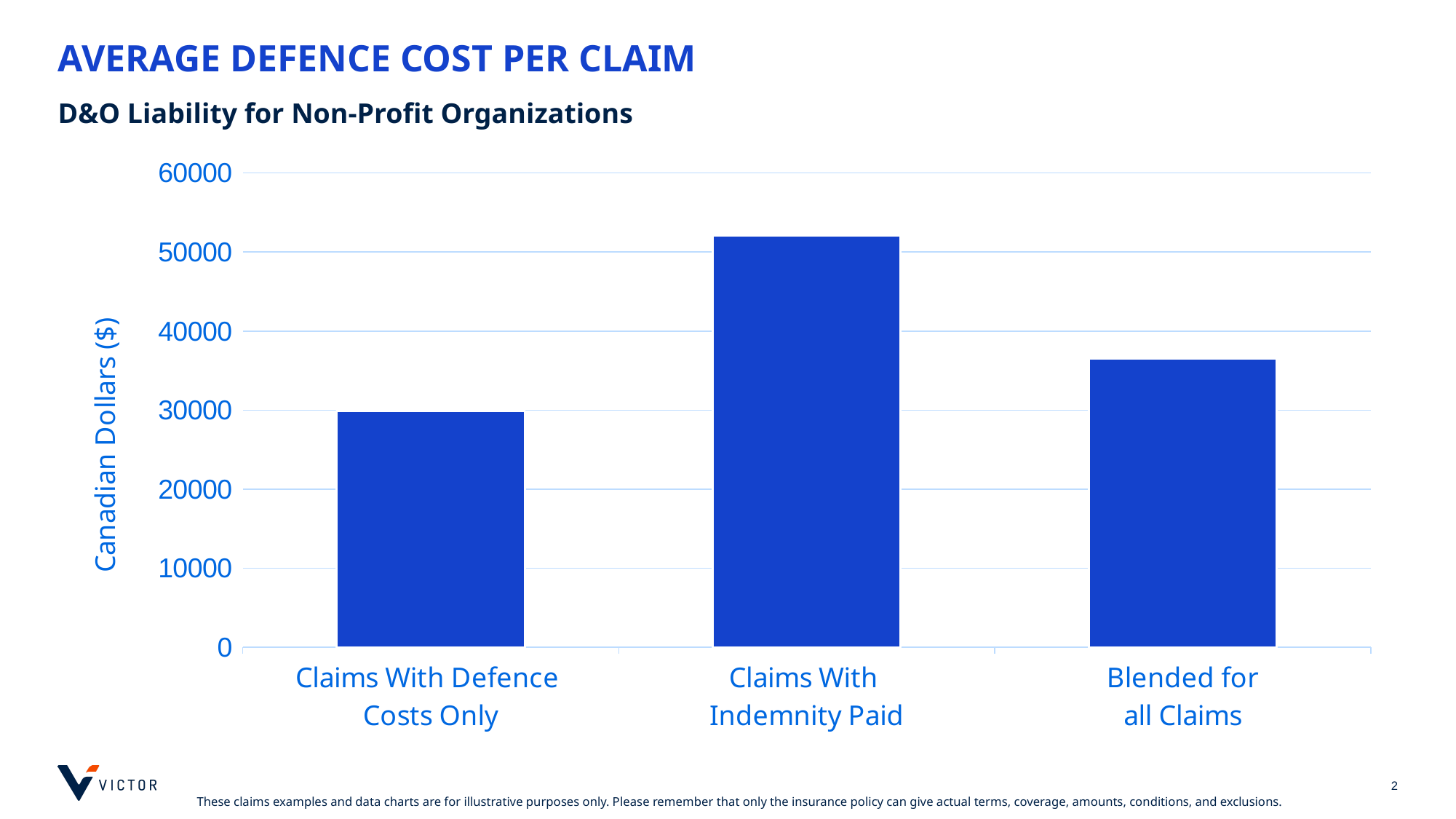
Is the value for Claims With Indemnity Paid greater or less than 50000? greater Is the value for Blended for all Claims greater or less than 40000? less How many categories are plotted in the chart? 3 What is the label on the vertical axis of the chart? Canadian Dollars ($) Which is larger: the value for Claims With Indemnity Paid or the value for Blended for all Claims? Claims With Indemnity Paid What is the title of the chart on the slide? AVERAGE DEFENCE COST PER CLAIM Which category has the highest average defence cost per claim? Claims With Indemnity Paid What kind of chart is shown on the slide? bar chart Which is larger: the value for Blended for all Claims or the value for Claims With Defence Costs Only? Blended for all Claims Which category has the lowest average defence cost per claim? Claims With Defence Costs Only Is the value for Blended for all Claims greater or less than 30000? greater